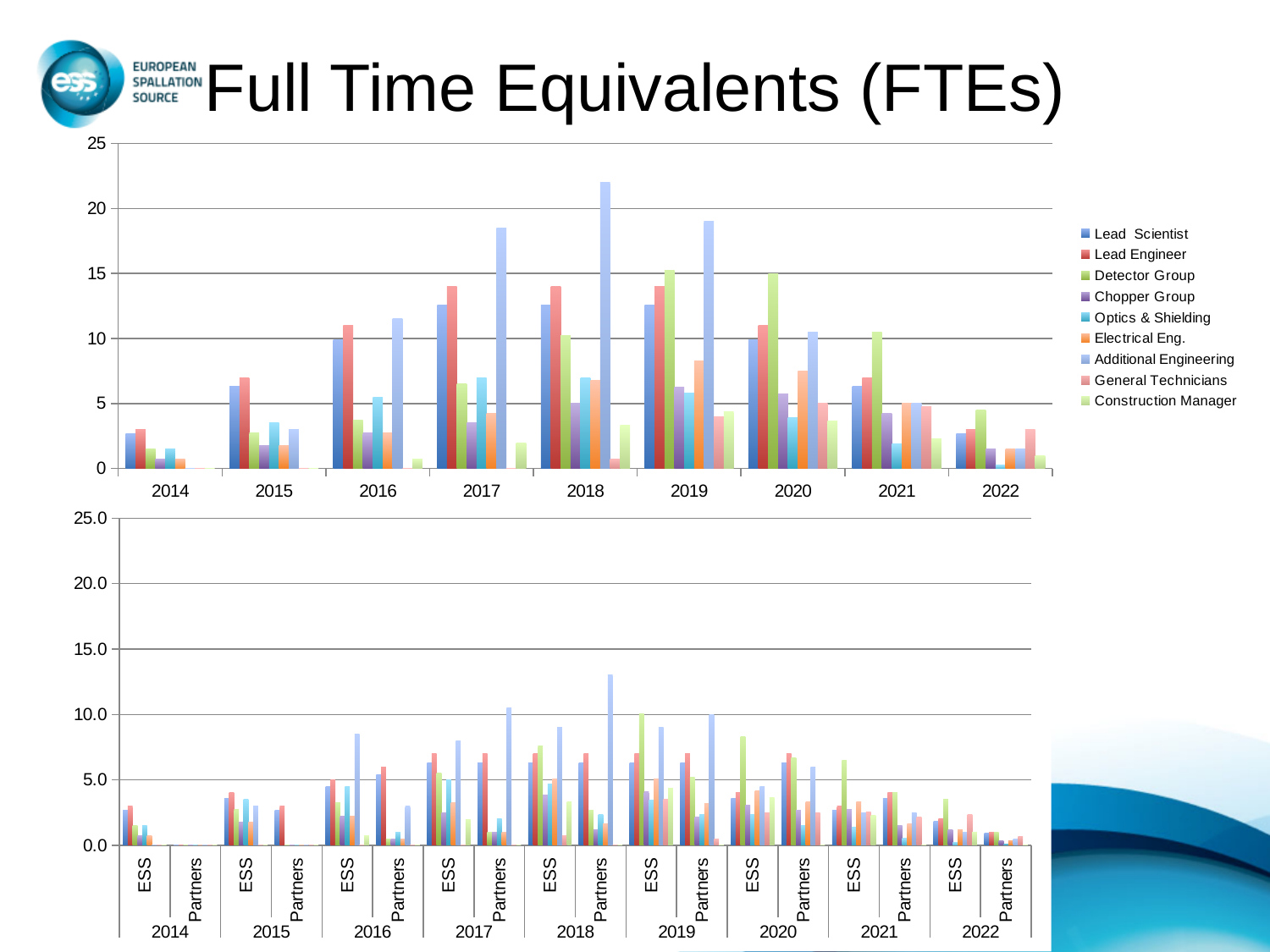
In the top chart, is the Additional Engineering value for 2018 greater or less than 20? greater How many series does the legend of the top chart list? 9 What kind of chart is the bottom chart on the slide? bar chart In the top chart, is the Lead Engineer value for 2017 greater or less than 10? greater In the top chart, is the Detector Group value for 2020 greater or less than 10? greater In the top chart, which is larger: the Additional Engineering value for 2018 or for 2019? 2018 How many year categories are shown on the x axis of the top chart? 9 In the top chart, in which year is the Additional Engineering value highest? 2018 In the top chart, does the Lead Scientist value rise or fall from 2014 to 2017? rise What kind of chart is the top chart on the slide? bar chart In the top chart, which is larger: the Lead Scientist value for 2015 or for 2017? 2017